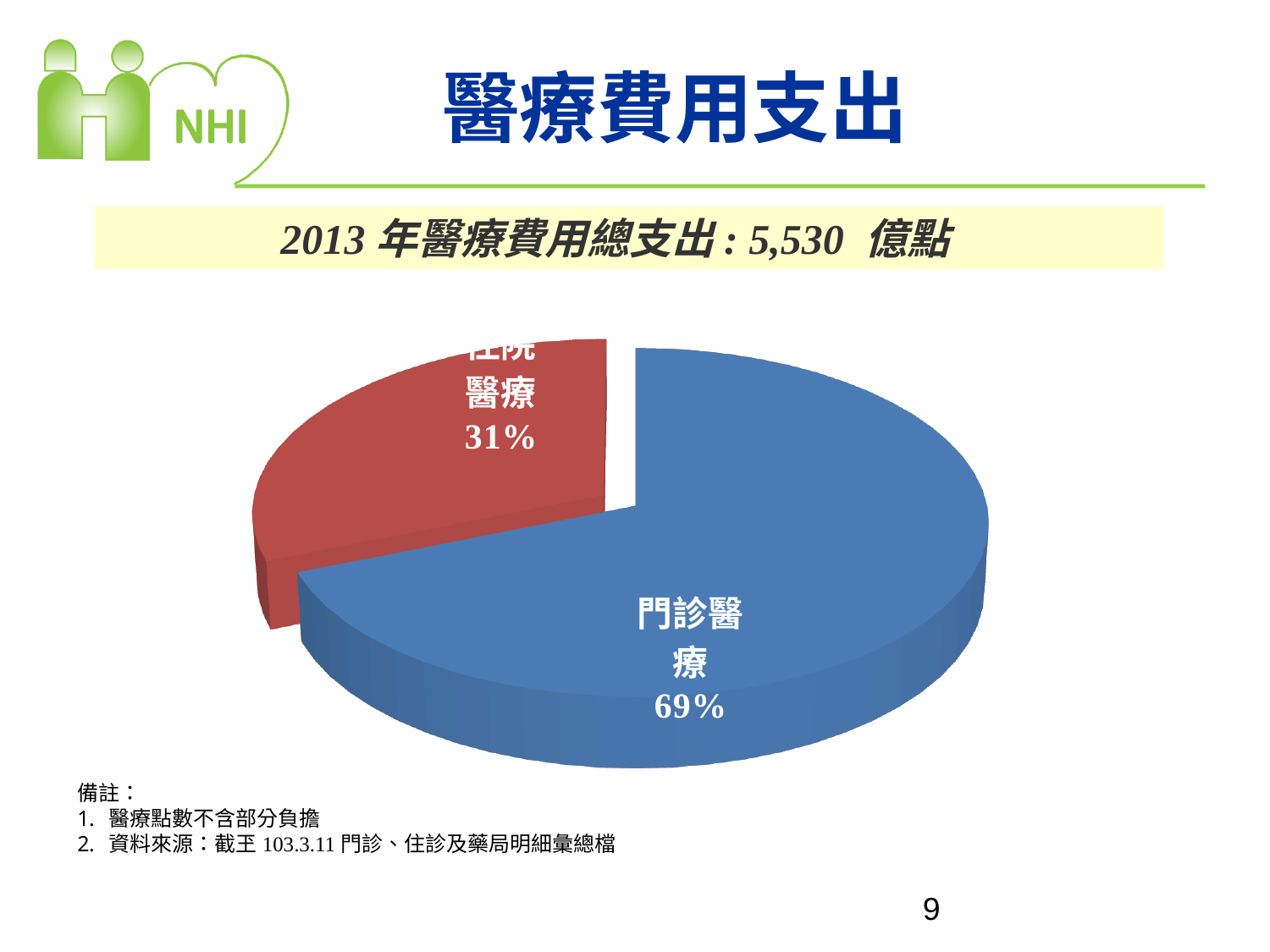
Which slice of the pie is the smallest? 住院醫療 What share of the pie does 門診醫療 account for? 69% What share of the pie does 住院醫療 account for? 31% How many slices does the pie chart have? 2 What is the title of the slide containing the pie chart? 醫療費用支出 Which slice of the pie is the largest? 門診醫療 What colour is the 門診醫療 slice? blue Is the share for 住院醫療 greater or less than 50%? less What is the difference in percentage points between the 門診醫療 and 住院醫療 slices? 38 What kind of chart is shown on the slide? pie chart Which is larger, the 門診醫療 slice or the 住院醫療 slice? 門診醫療